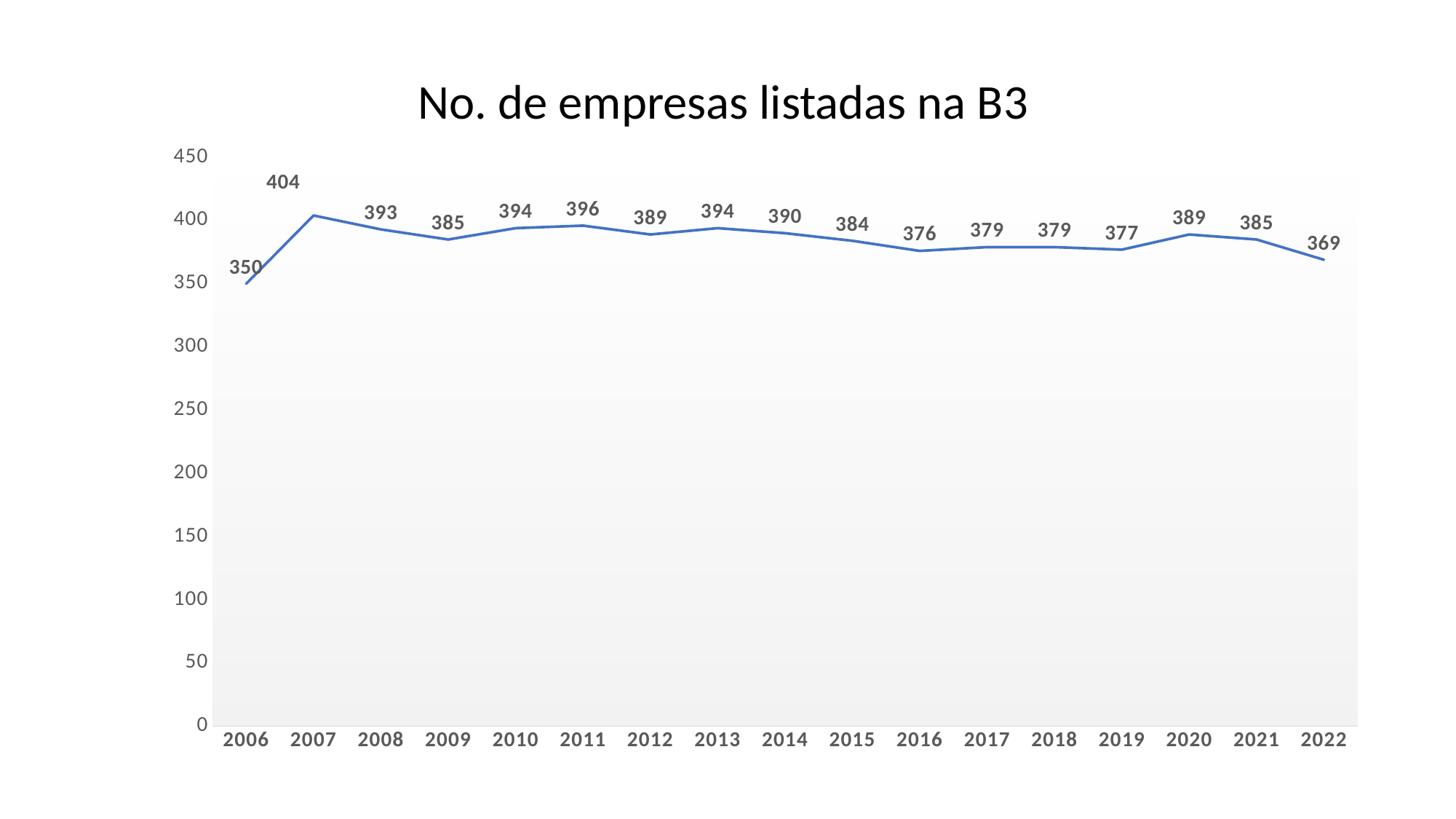
What kind of chart is shown? line chart Is the value for 2013 greater or less than 350? greater Which year has the lowest value? 2006 What is the value shown for 2022? 369 What is the difference between the values for 2020 and 2022? 20 Which year has the highest value? 2007 What is the title of the chart? No. de empresas listadas na B3 How many years are plotted on the x axis? 17 What is the difference between the values for 2007 and 2006? 54 Which is larger, the value for 2011 or the value for 2019? 2011 What is the value shown for 2016? 376 What is the number of companies listed on B3 in 2007? 404